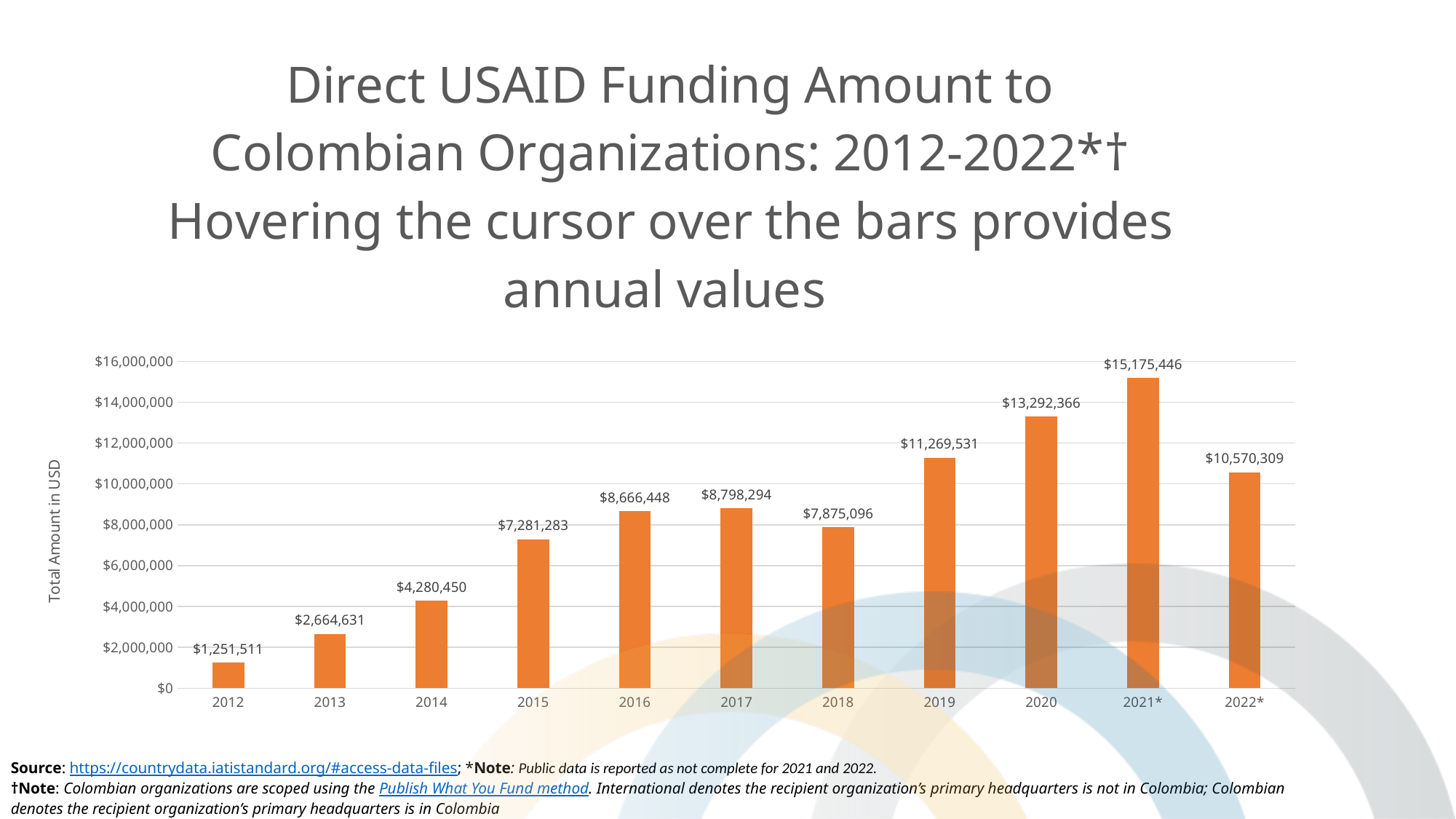
Which year has the highest funding amount? 2021* What is the value shown for 2020? $13,292,366 Do the funding amounts rise or fall from 2012 to 2016? Rise Which year has a larger funding amount, 2018 or 2019? 2019 What is the value shown for 2022*? $10,570,309 What is the difference between the 2017 and 2016 funding amounts? $131,846 What is the direct USAID funding amount to Colombian organizations in 2015? $7,281,283 What is the difference between the 2021* and 2020 funding amounts? $1,883,080 What kind of chart is shown on the slide? Bar chart Is the value for 2019 greater or less than $10,000,000? greater How many years are shown on the x axis? 11 Which year has the lowest funding amount? 2012